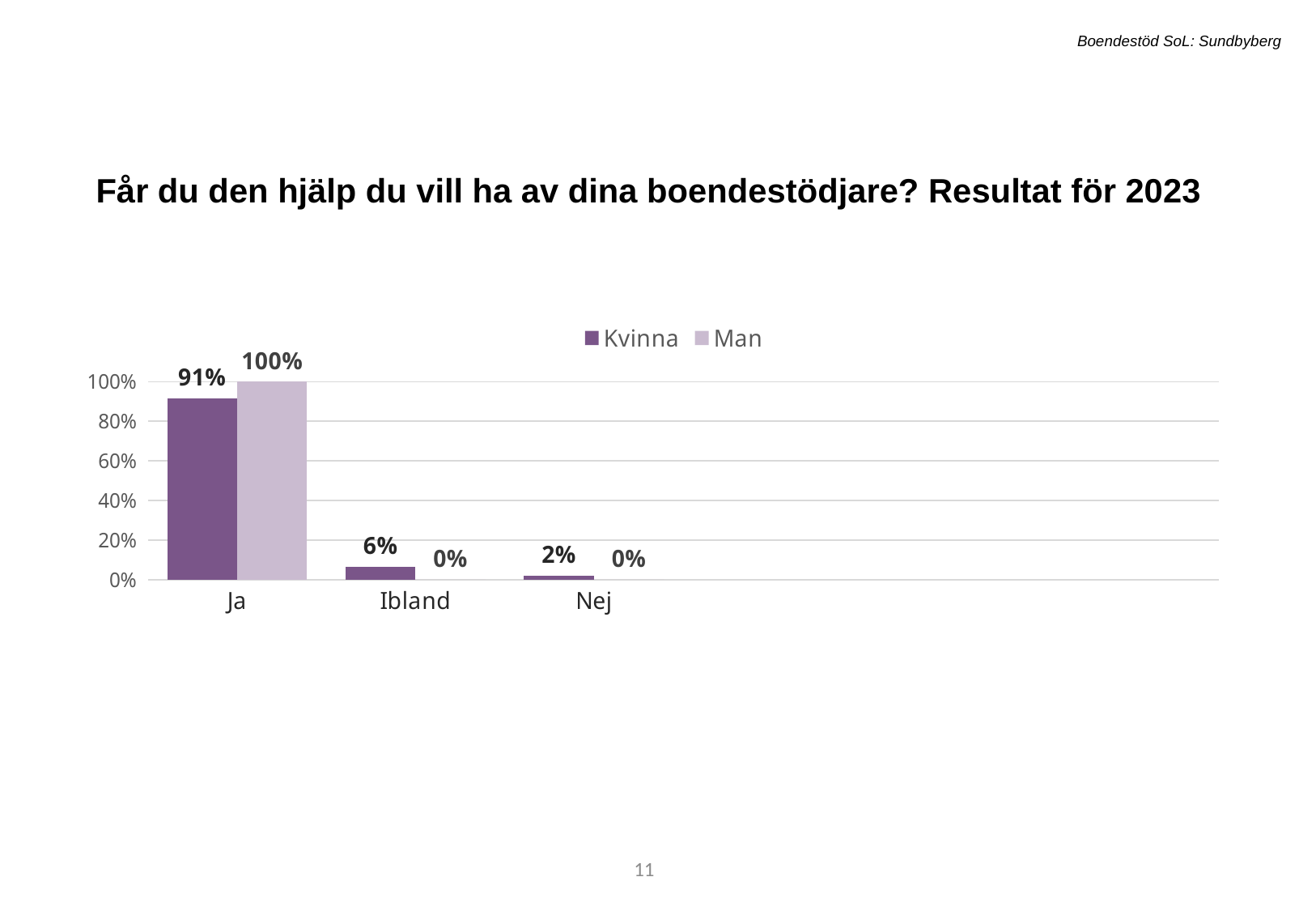
Which is larger in the Ja category, Kvinna or Man? Man What is the value for Man in the Nej category? 0% What is the difference between the Man and Kvinna values in the Ja category? 9% Which category has the lowest value for Kvinna? Nej Which category has the highest value for Kvinna? Ja What kind of chart is shown on the slide? Bar chart How many series does the legend list? 2 What is the value for Kvinna in the Ibland category? 6% What is the value for Kvinna in the Nej category? 2% How many categories are shown on the x axis? 3 What is the value for Man in the Ja category? 100% What is the value for Kvinna in the Ja category? 91%